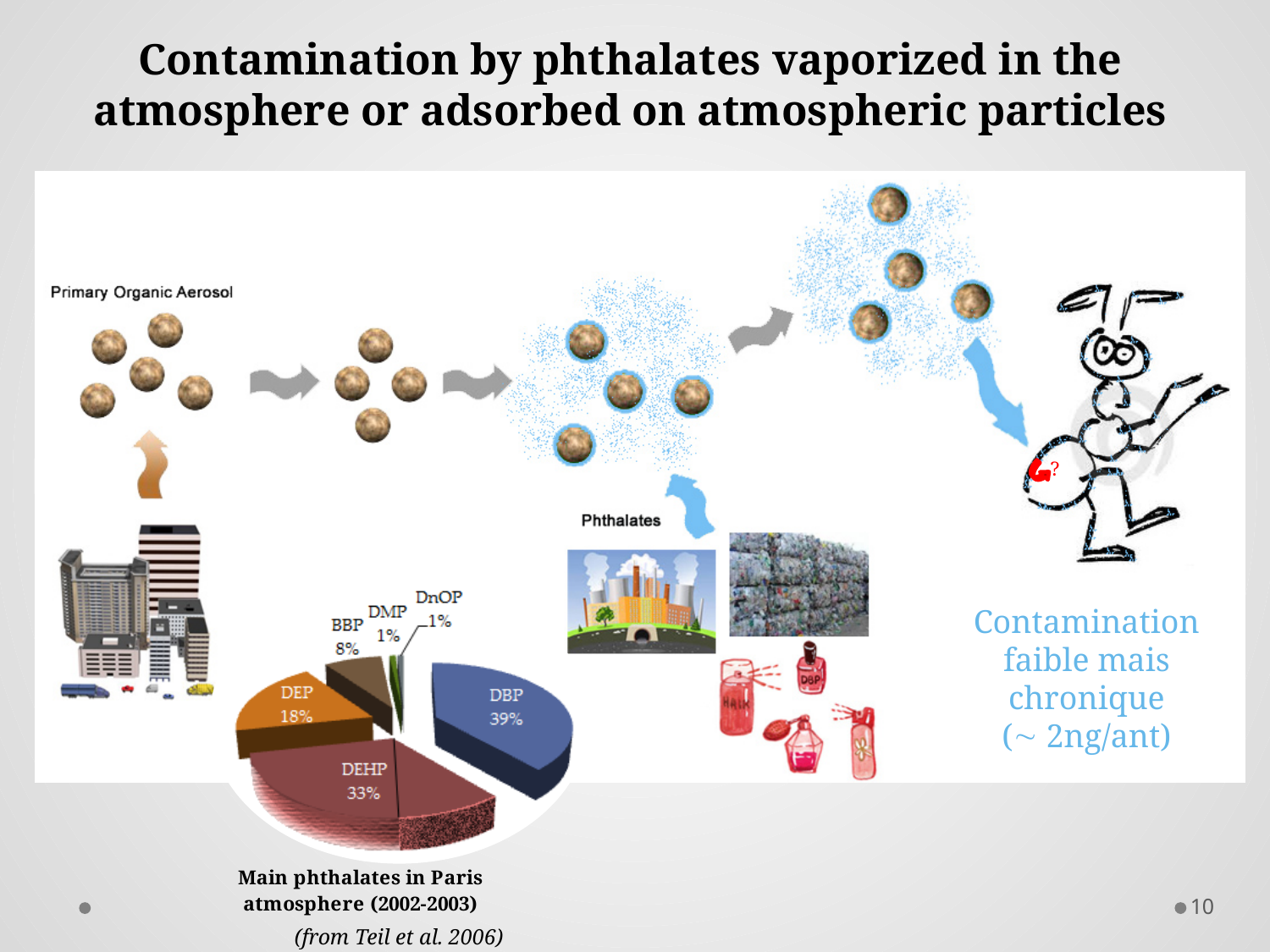
What is the difference in percentage points between the DBP and DEHP shares? 6 What share of the pie chart does BBP account for? 8% What type of chart is used to show the main phthalates in Paris atmosphere (2002-2003)? pie chart What is the combined share of DBP and DEHP in the pie chart? 72% What share of the pie chart does DMP account for? 1% What share of the pie chart does DBP account for? 39% What is the title of the pie chart? Main phthalates in Paris atmosphere (2002-2003) Which has a larger share in the pie chart, DEP or BBP? DEP Which phthalate has the largest share in the pie chart? DBP How many slices does the pie chart have? 6 What share of the pie chart does DEHP account for? 33% What share of the pie chart does DEP account for? 18%